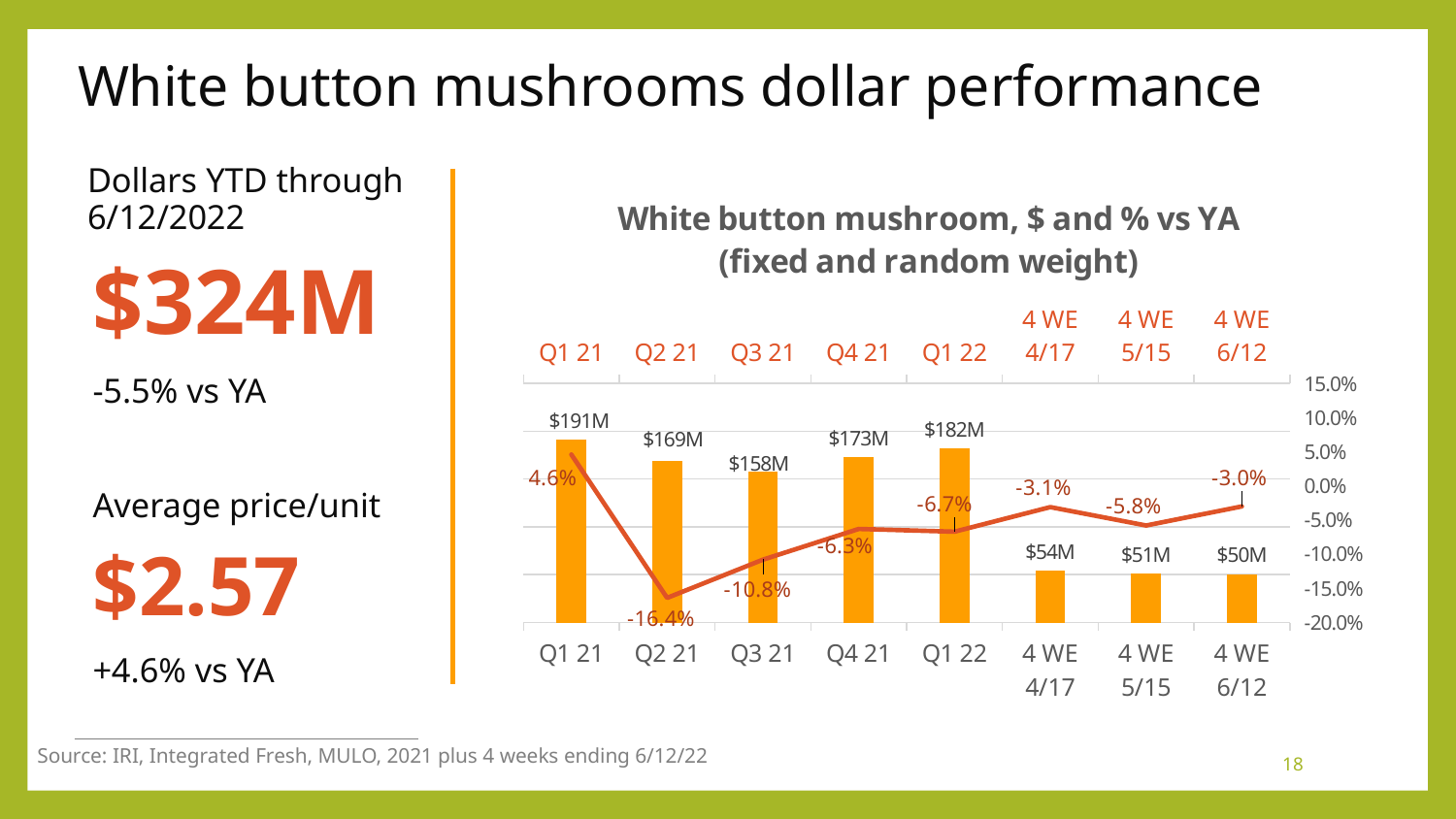
Which period has the highest dollar value? Q1 21 How many periods are shown on the x axis? 8 Which is larger, the dollar value for Q2 21 or for Q3 21? Q2 21 What kind of chart is this? Combination bar and line chart What is the dollar value shown for the 4 WE 6/12 period? $50M What is the title of the chart? White button mushroom, $ and % vs YA (fixed and random weight) What is the % vs YA value shown for Q1 22? -6.7% What is the difference in dollars between Q1 22 and Q4 21? $9M What is the % vs YA value shown for Q2 21? -16.4% Which period has the lowest % vs YA value? Q2 21 What is the dollar value shown for Q1 21? $191M Do the dollar values rise or fall from Q3 21 to Q1 22? Rise